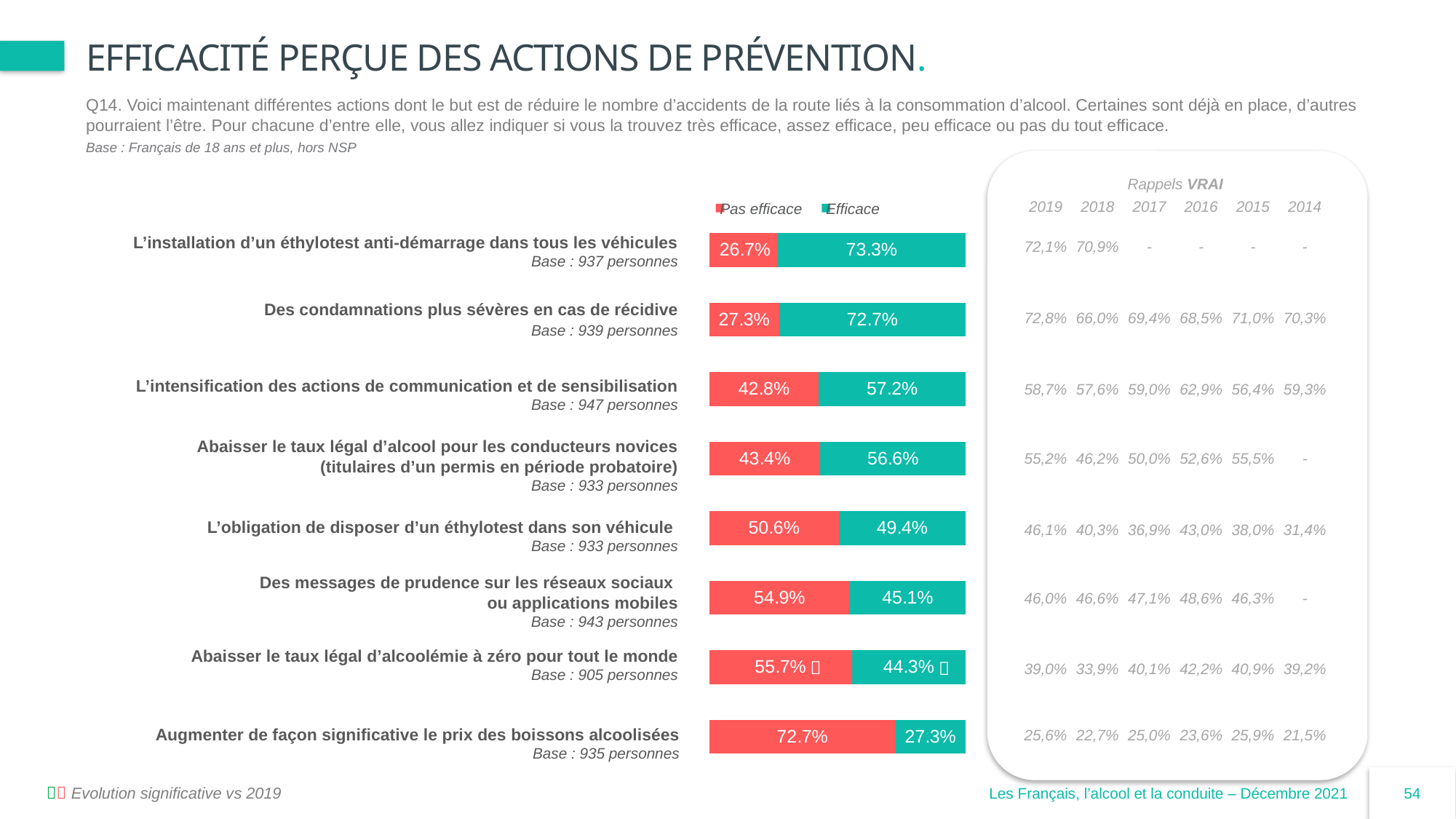
What is the total of the "Pas efficace" and "Efficace" values for "Abaisser le taux légal d'alcoolémie à zéro pour tout le monde"? 100% Which action has the highest "Efficace" percentage? L'installation d'un éthylotest anti-démarrage dans tous les véhicules How many series does the legend list? 2 How many actions are shown in the bar chart? 8 Which action has the lowest "Efficace" percentage? Augmenter de façon significative le prix des boissons alcoolisées What kind of chart is used to show the perceived effectiveness of the actions? Stacked bar chart What is the "Efficace" value for "L'obligation de disposer d'un éthylotest dans son véhicule"? 49.4% What percentage of respondents find "L'installation d'un éthylotest anti-démarrage dans tous les véhicules" efficace? 73.3% What is the "Pas efficace" value for "Augmenter de façon significative le prix des boissons alcoolisées"? 72.7% What is the difference between the "Pas efficace" and "Efficace" values for "Des messages de prudence sur les réseaux sociaux ou applications mobiles"? 9.8% Which is larger: the "Efficace" value for "Des condamnations plus sévères en cas de récidive" or for "L'intensification des actions de communication et de sensibilisation"? Des condamnations plus sévères en cas de récidive Which colour represents the "Efficace" series in the chart? Green (teal)